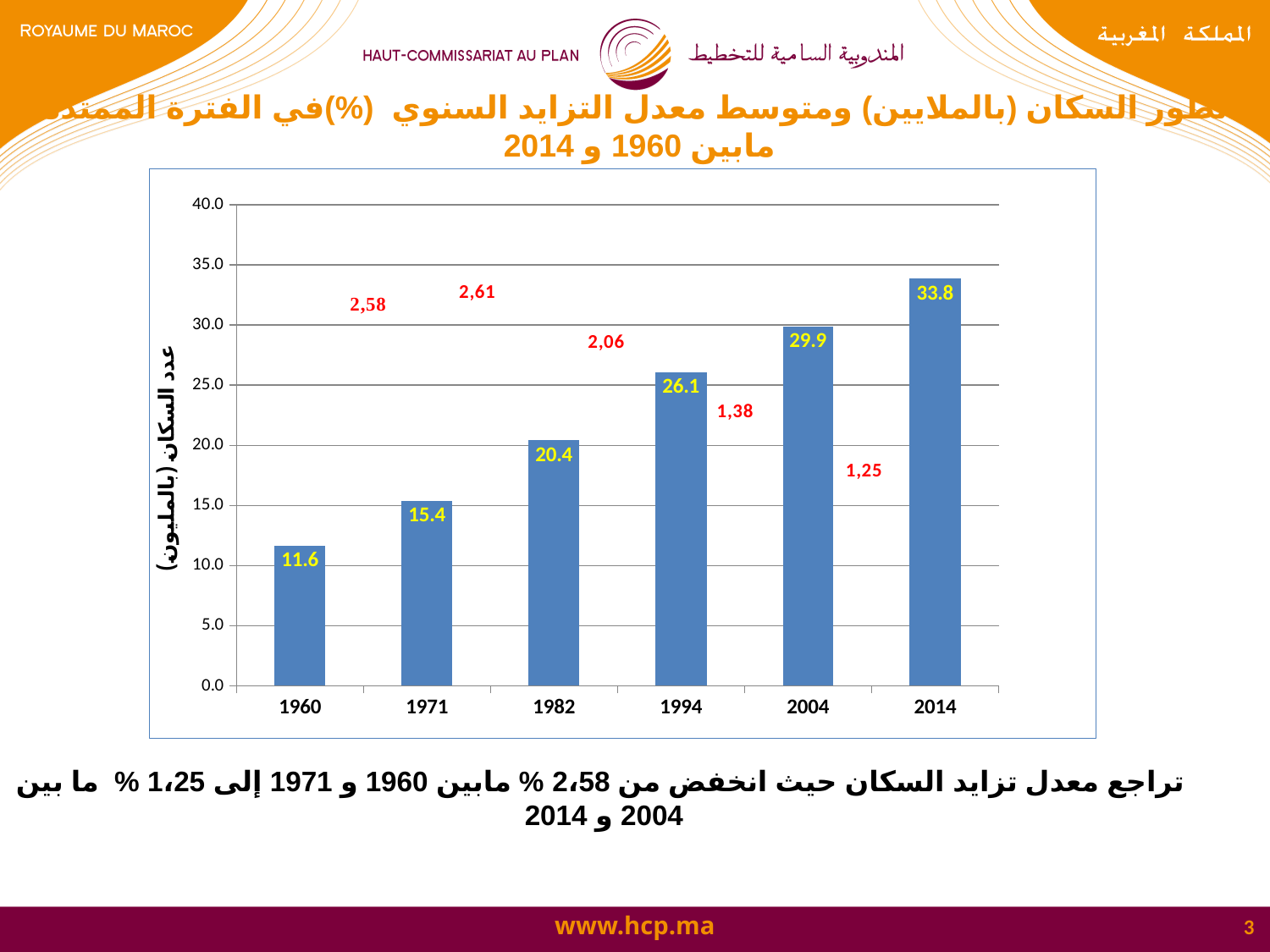
How many years (bars) are shown on the x axis? 6 What is the population value shown for 1960? 11.6 Which is larger, the population value for 1982 or for 1971? 1982 Which year has the highest population bar? 2014 What is the difference between the population values for 2014 and 1960? 22.2 What is the population value shown for 2014? 33.8 What is the population value shown for 1994? 26.1 What kind of chart is shown on the slide? bar chart Which year has the lowest population bar? 1960 What is the red growth-rate label shown between the 2004 and 2014 bars? 1,25 Do the population values rise or fall from 1960 to 2014? rise What is the difference between the population values for 2004 and 1994? 3.8